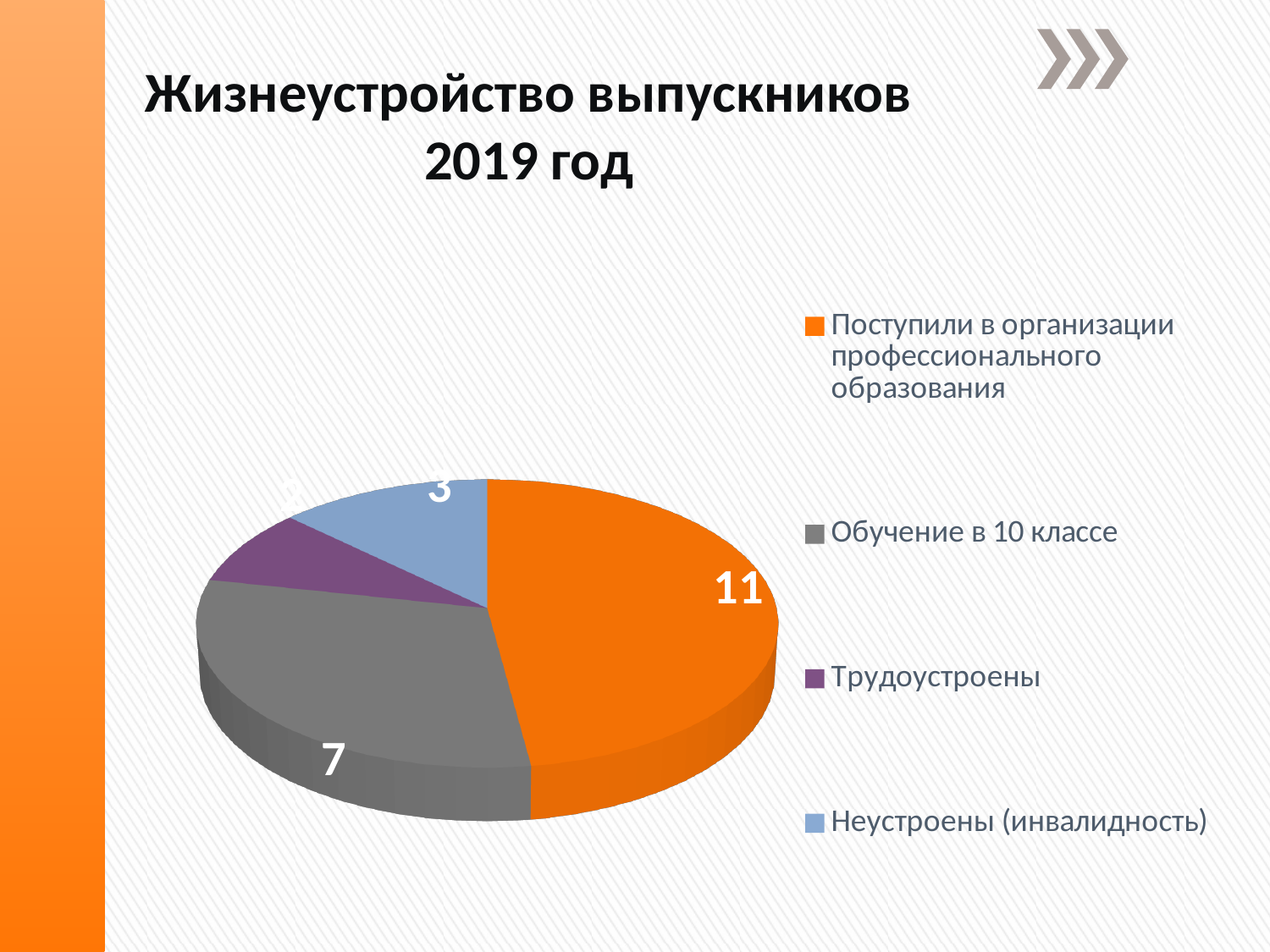
Which category has the largest slice of the pie? Поступили в организации профессионального образования What type of chart is shown on the slide? pie chart What is the value for "Обучение в 10 классе"? 7 What colour is the slice for "Обучение в 10 классе"? gray How many graduates are shown for "Поступили в организации профессионального образования"? 11 How many categories does the pie chart have? 4 Which is larger: "Неустроены (инвалидность)" or "Трудоустроены"? Неустроены (инвалидность) What is the total of all the slices in the pie chart? 23 Which category has the smallest slice of the pie? Трудоустроены What is the value for "Неустроены (инвалидность)"? 3 What is the value for "Трудоустроены"? 2 What is the difference between the values for "Поступили в организации профессионального образования" and "Обучение в 10 классе"? 4